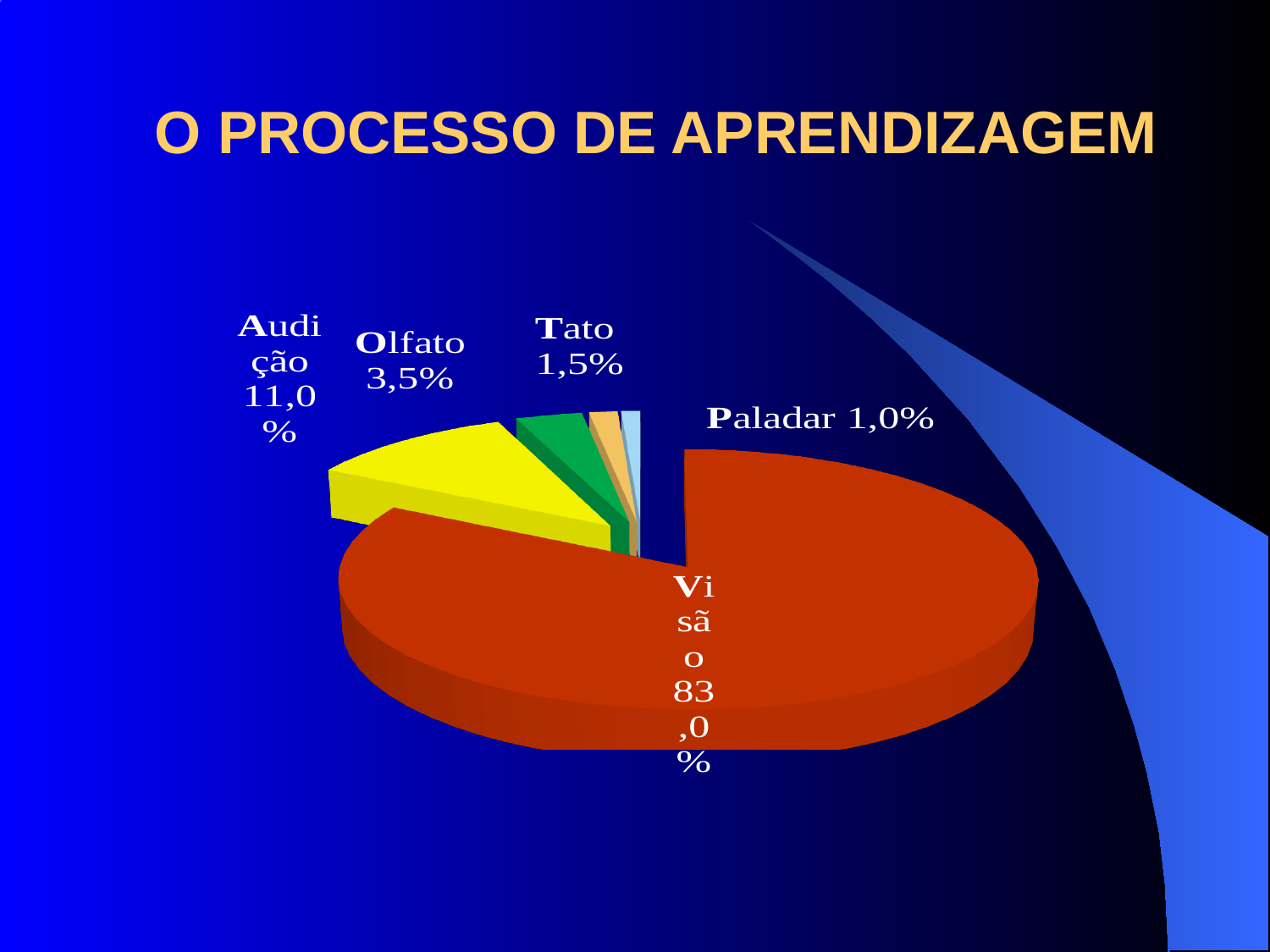
What percentage is shown for Paladar? 1,0% What kind of chart is shown on the slide? pie chart What percentage is shown for Olfato? 3,5% What percentage is shown for Tato? 1,5% What percentage is shown for Visão? 83,0% Which slice of the pie is the largest? Visão How many slices does the pie chart have? 5 Which is larger, the slice for Olfato or the slice for Tato? Olfato Which slice of the pie is the smallest? Paladar What is the difference between the percentages for Visão and Audição? 72,0% What percentage is shown for Audição? 11,0% What is the title of the slide containing the pie chart? O PROCESSO DE APRENDIZAGEM